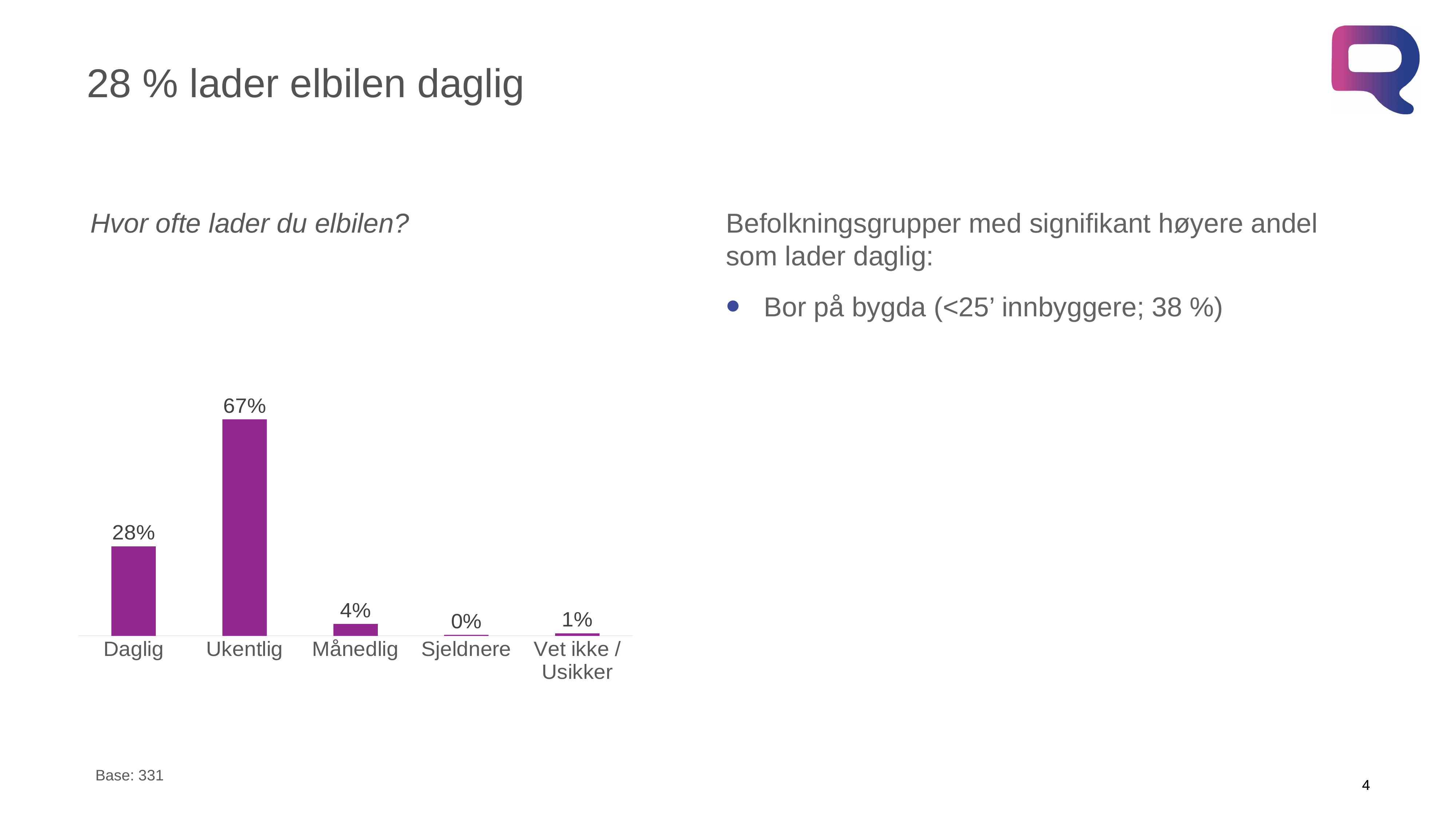
What is the value shown for Ukentlig? 67% What is the value shown for Månedlig? 4% What is the difference between the values for Månedlig and Vet ikke / Usikker? 3% What kind of chart is shown on the slide? Bar chart What is the value shown for Vet ikke / Usikker? 1% Which category has the highest value? Ukentlig What percentage of respondents charge their electric car daily (Daglig)? 28% How many categories are shown on the x axis of the chart? 5 Which category has the lowest value? Sjeldnere What is the difference between the values for Ukentlig and Daglig? 39% Which is larger, the value for Daglig or the value for Månedlig? Daglig What question does the chart answer, as written above it? Hvor ofte lader du elbilen?